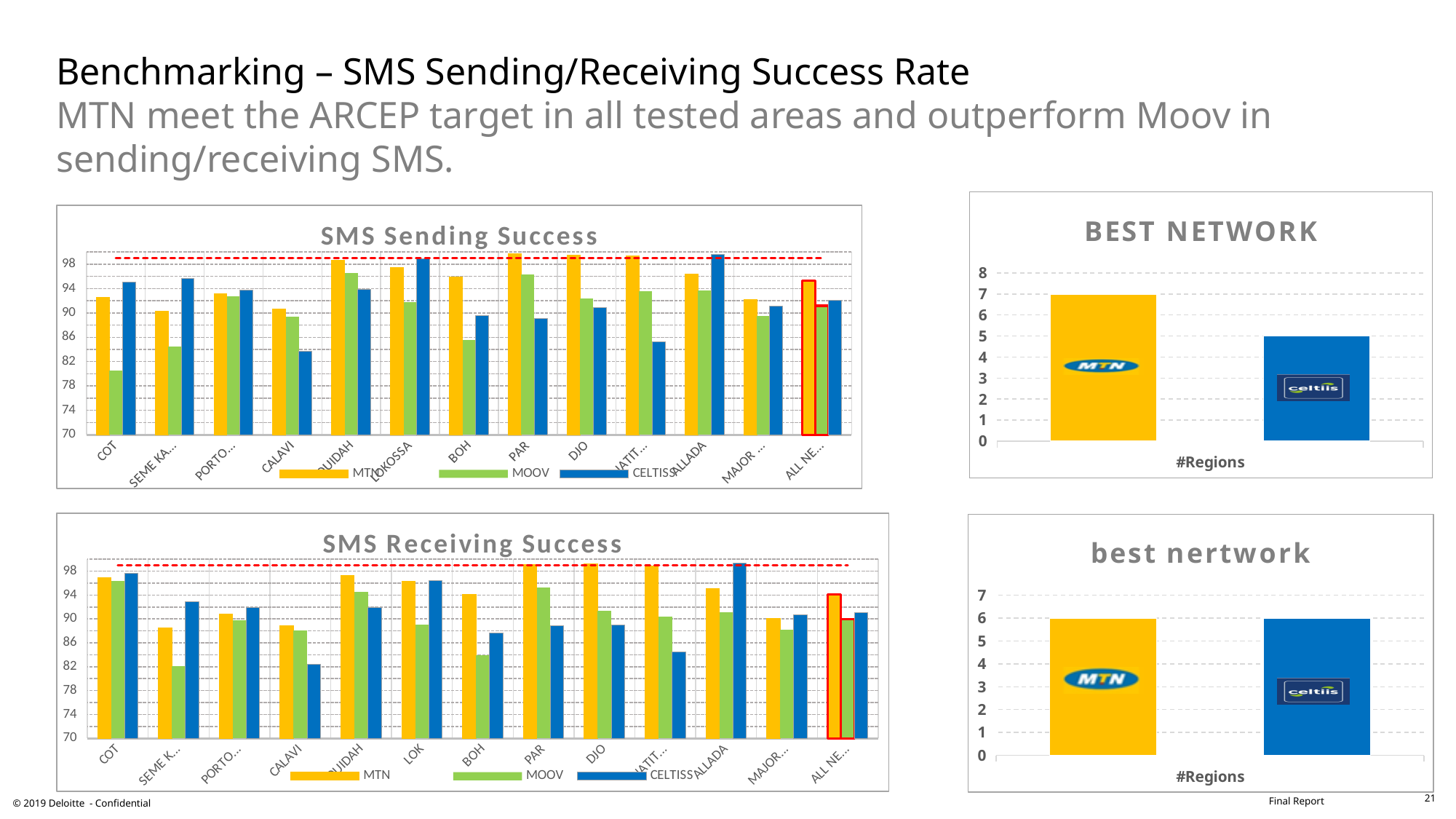
How many series does the legend of the SMS Sending Success chart list? 3 In the SMS Sending Success chart, is the MTN value for COT greater or less than 90? greater In the BEST NETWORK chart (top right), which network has the higher bar? MTN In the BEST NETWORK chart (top right), what is the value for MTN? 7 In the BEST NETWORK chart (top right), what is the value for Celtiis? 5 In the SMS Receiving Success chart, is the MOOV value for SEME K... greater or less than 86? less In the BEST NETWORK chart (top right), what is the difference between the MTN and Celtiis values? 2 What kind of chart is the SMS Sending Success chart? bar chart What is the x-axis label of the BEST NETWORK chart (top right)? #Regions In the SMS Receiving Success chart, which is larger for BOH: the MTN value or the MOOV value? MTN In the best nertwork chart (bottom right), what is the value for MTN? 6 How many categories are shown on the x axis of the SMS Sending Success chart? 13